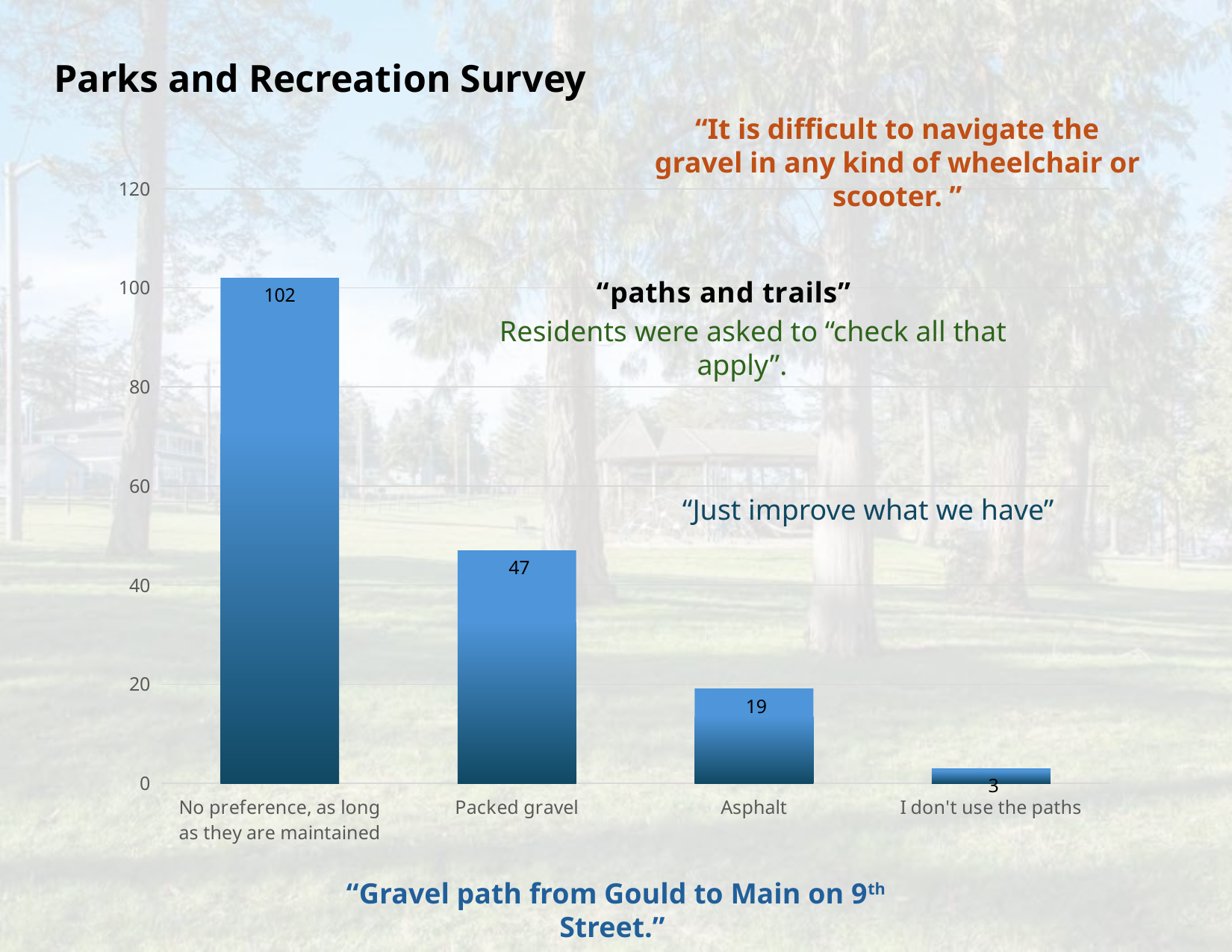
What is the value for Packed gravel? 47 Which category has the lowest value? I don't use the paths What is the value for "I don't use the paths"? 3 What is the value for Asphalt? 19 What kind of chart is shown on the slide? Bar chart Which is larger, the value for Asphalt or the value for Packed gravel? Packed gravel How many categories are shown in the chart? 4 What is the difference between the values for Packed gravel and Asphalt? 28 What is the difference between the values for "No preference, as long as they are maintained" and Packed gravel? 55 Do the values rise or fall from left to right across the categories? Fall What is the value for "No preference, as long as they are maintained"? 102 Which category has the highest value? No preference, as long as they are maintained